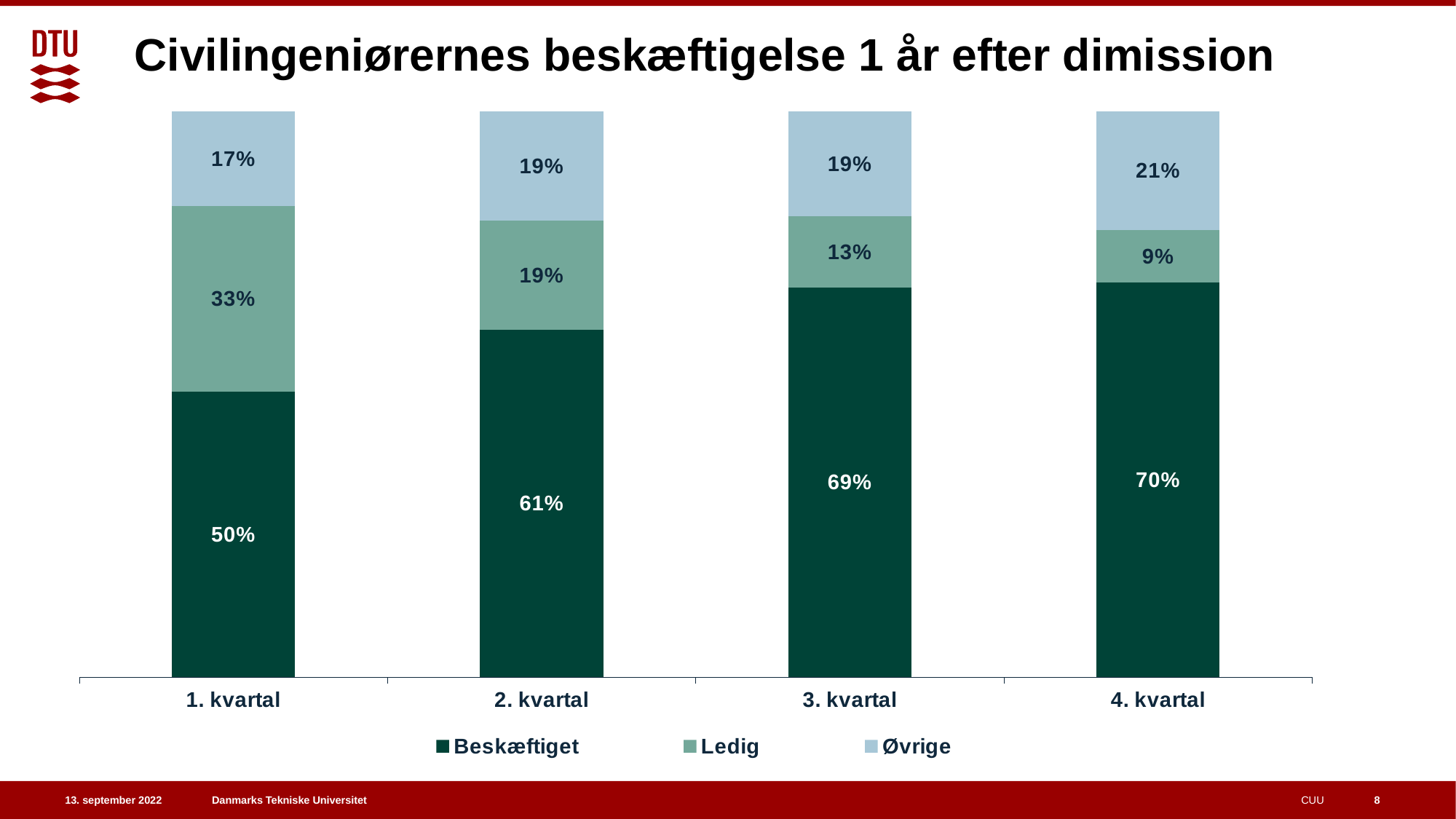
Which quarter has the highest Beskæftiget value? 4. kvartal What is the Beskæftiget value for 1. kvartal? 50% What is the Ledig value for 3. kvartal? 13% Does the Beskæftiget value rise or fall from 1. kvartal to 4. kvartal? Rise How many series does the legend list? 3 Which quarter has the lowest Ledig value? 4. kvartal What is the title of the chart? Civilingeniørernes beskæftigelse 1 år efter dimission How many quarters are shown on the x axis? 4 What is the Øvrige value for 4. kvartal? 21% What kind of chart is shown on the slide? Stacked bar chart Which is larger: the Ledig value for 1. kvartal or the Ledig value for 2. kvartal? 1. kvartal What is the difference between the Beskæftiget values for 2. kvartal and 1. kvartal? 11%